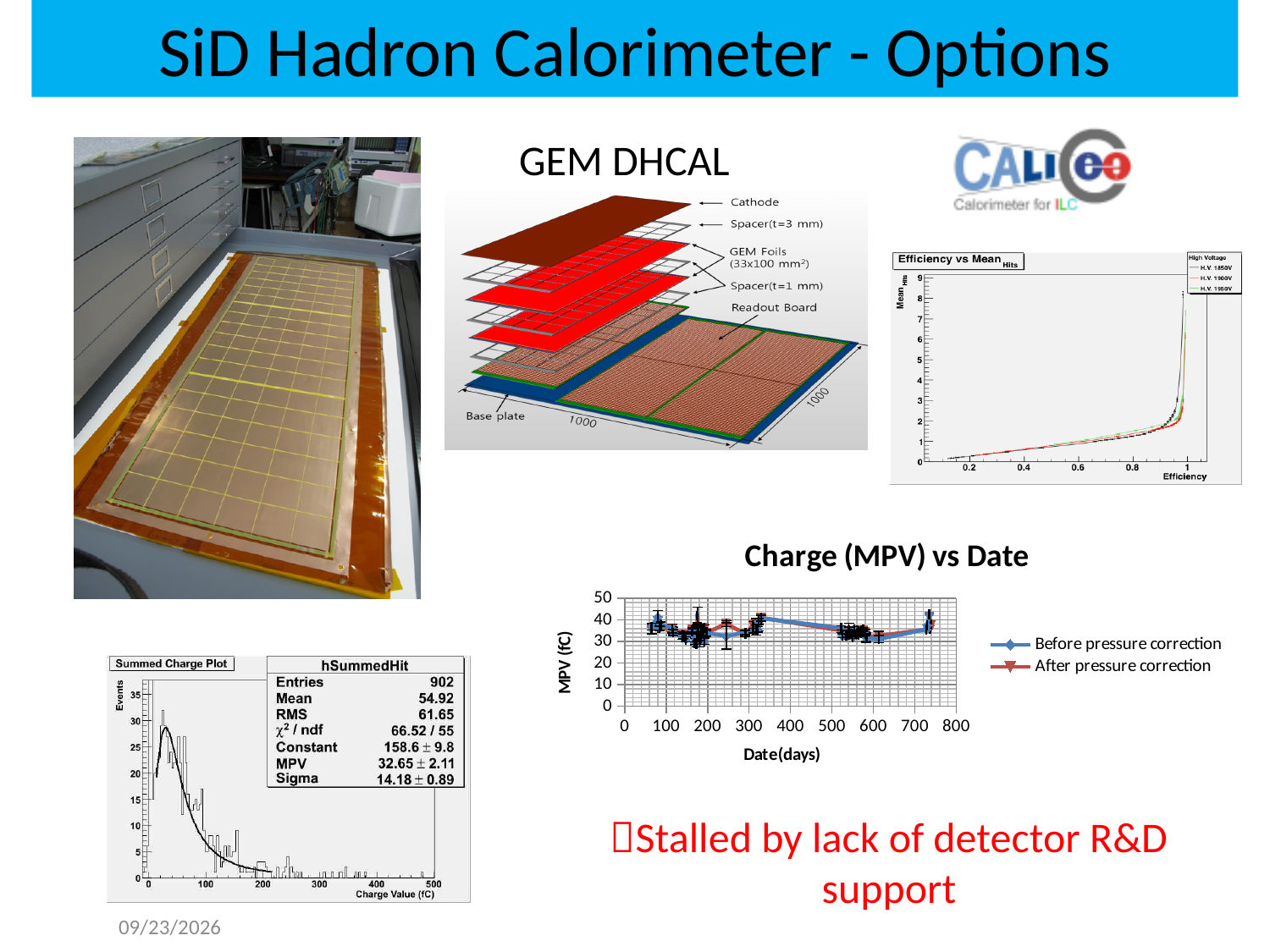
In the 'Charge (MPV) vs Date' chart, what are the two legend entries? Before pressure correction; After pressure correction In the 'Charge (MPV) vs Date' chart, is the MPV value at around 600 days greater or less than 50? less In the 'Summed Charge Plot', what is the Mean value shown in the statistics box? 54.92 In the 'Summed Charge Plot', what is the RMS value shown in the statistics box? 61.65 In the 'Summed Charge Plot', what is the number of entries shown in the statistics box? 902 In the 'Charge (MPV) vs Date' chart, what is the label of the y axis? MPV (fC) In the 'Charge (MPV) vs Date' chart, how many series does the legend list? 2 In the 'Summed Charge Plot', what is the MPV value shown in the statistics box? 32.65 ± 2.11 In the 'Efficiency vs Mean Hits' chart, do the mean hits rise or fall as efficiency increases along the x axis? rise In the 'Charge (MPV) vs Date' chart, what is the highest tick value shown on the x axis? 800 In the 'Efficiency vs Mean Hits' chart, how many high-voltage series does the legend list? 3 In the 'Charge (MPV) vs Date' chart, is the MPV value at around 100 days greater or less than 20? greater